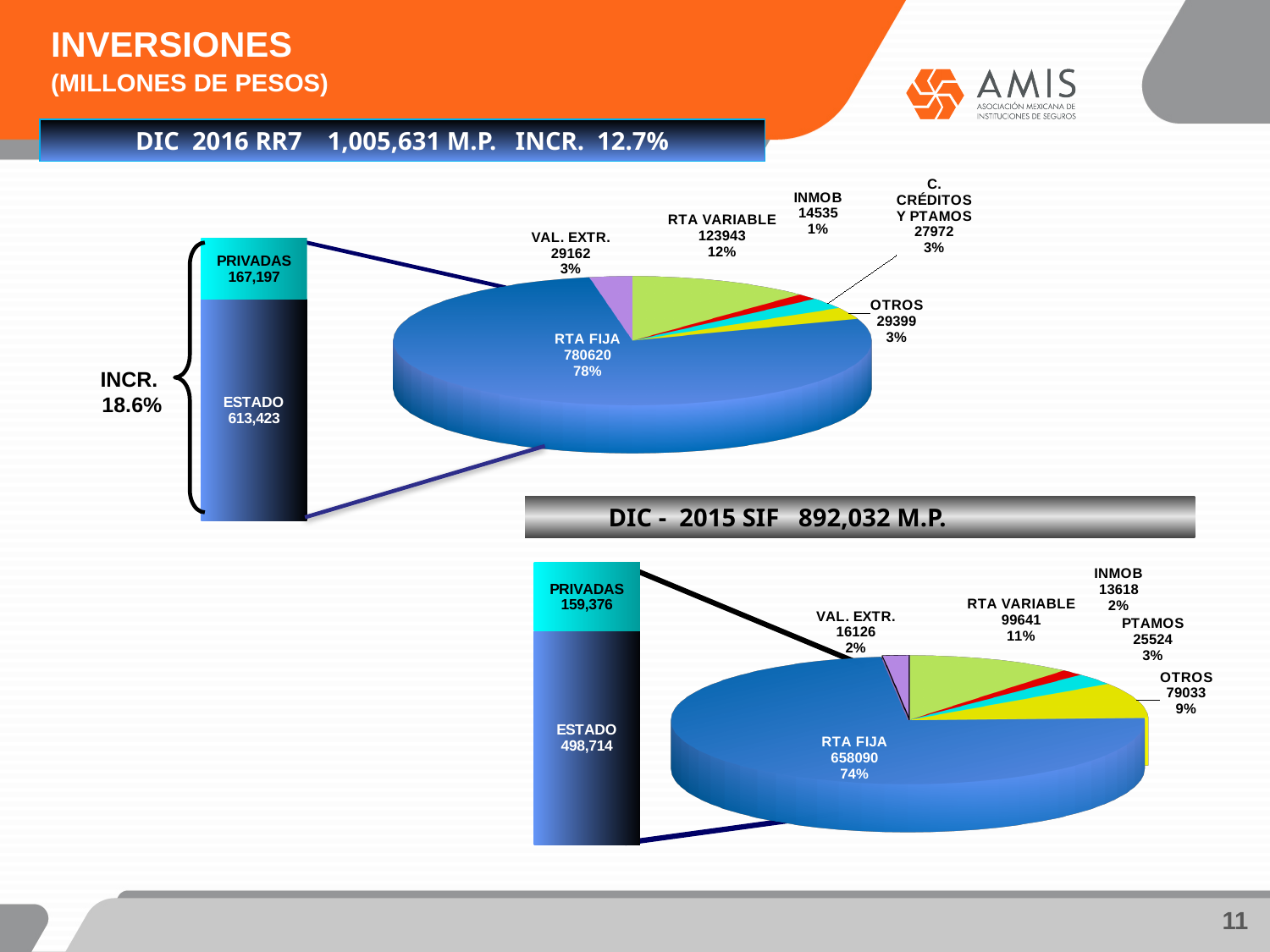
In the stacked bar next to the DIC - 2015 SIF pie chart, what is the total of PRIVADAS and ESTADO? 658,090 In the DIC 2016 RR7 pie chart, what share of the pie does RTA VARIABLE represent? 12% What is the difference between the RTA VARIABLE value in the DIC 2016 RR7 pie chart and the RTA VARIABLE value in the DIC - 2015 SIF pie chart? 24302 In the DIC 2016 RR7 pie chart, which category has the smallest slice? INMOB In the DIC 2016 RR7 pie chart, how many slices are there? 6 What type of chart is used to show the breakdown of RTA FIJA, RTA VARIABLE, INMOB and the other categories on this slide? Pie chart In the DIC - 2015 SIF pie chart, what is the value shown for OTROS? 79033 In the DIC 2016 RR7 pie chart, what is the value shown for RTA FIJA? 780620 In the DIC - 2015 SIF pie chart, which category has the largest slice? RTA FIJA Which is larger: the PRIVADAS value in the 2016 stacked bar or the PRIVADAS value in the 2015 stacked bar? 2016 (167,197) In the stacked bar next to the DIC 2016 RR7 pie chart, what is the value for ESTADO? 613,423 In the DIC - 2015 SIF pie chart, what share of the pie does RTA FIJA represent? 74%